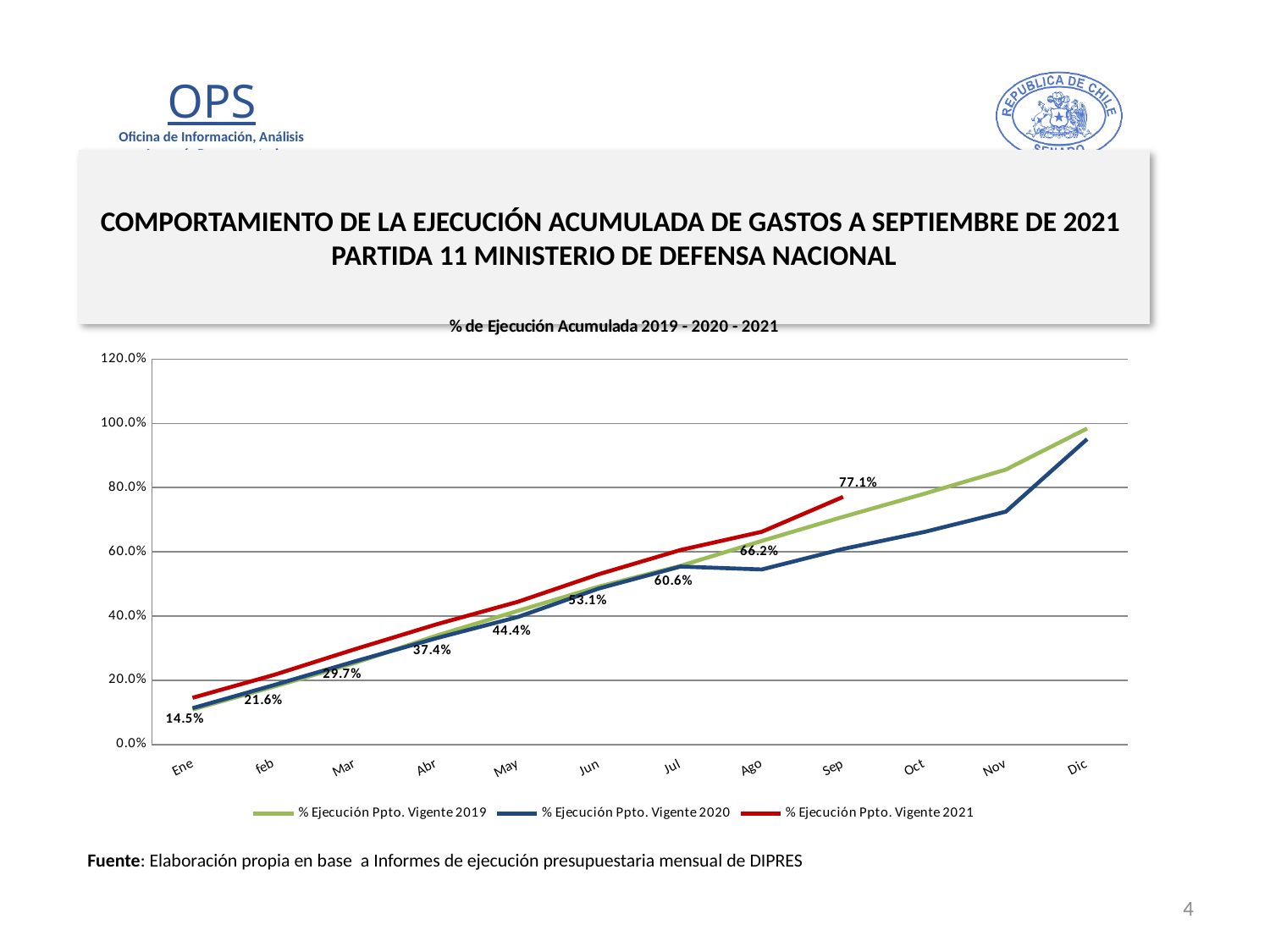
What is the value for % Ejecución Ppto. Vigente 2021 in Sep? 77.1% Is the value for % Ejecución Ppto. Vigente 2019 in Dic greater or less than 80.0%? greater By how many percentage points did % Ejecución Ppto. Vigente 2021 increase from Ago to Sep? 10.9 percentage points In Sep, which series has the higher value: % Ejecución Ppto. Vigente 2021 or % Ejecución Ppto. Vigente 2020? % Ejecución Ppto. Vigente 2021 What is the value for % Ejecución Ppto. Vigente 2021 in Jun? 53.1% What is the title of the chart? % de Ejecución Acumulada 2019 - 2020 - 2021 What kind of chart is shown? Line chart How many months are shown on the x axis? 12 How many series does the legend list? 3 What is the value for % Ejecución Ppto. Vigente 2021 in Abr? 37.4% What is the value for % Ejecución Ppto. Vigente 2021 in Ene? 14.5% By how many percentage points did % Ejecución Ppto. Vigente 2021 increase from Ene to Sep? 62.6 percentage points